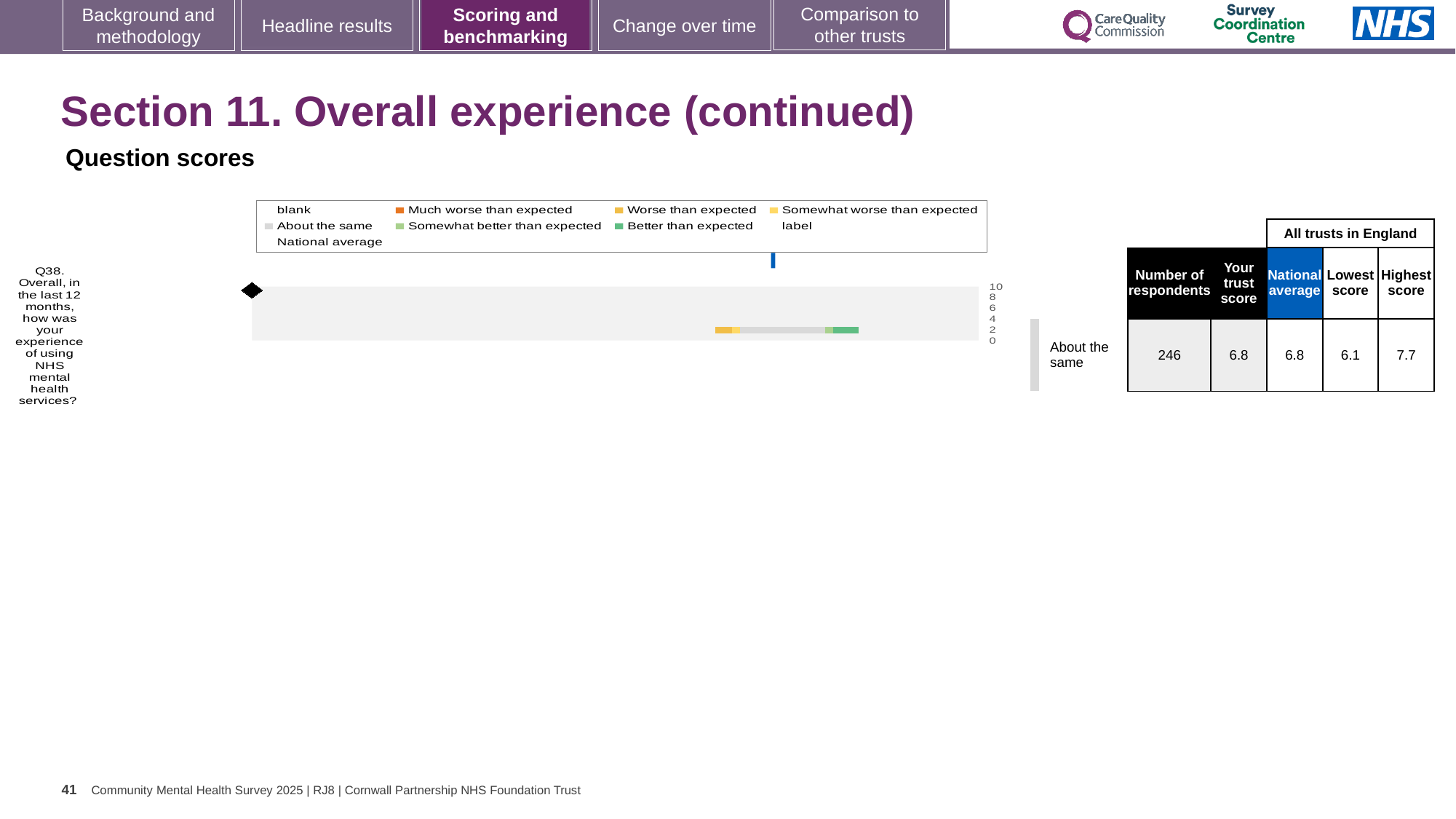
How many respondents answered Q38? 246 What is the lowest score among all trusts in England for Q38? 6.1 Is the trust score for Q38 greater or less than 4? greater Which question number is plotted in the chart? Q38 What benchmark category label is shown next to the bar for Q38? About the same What kind of chart is shown on the slide? Bar chart What is the trust score for Q38? 6.8 Which is larger for Q38, the highest score or the trust score? Highest score What is the national average score for Q38? 6.8 What is the highest score among all trusts in England for Q38? 7.7 How many survey questions are plotted in the chart? 1 What is the difference between the highest score and the lowest score for Q38? 1.6